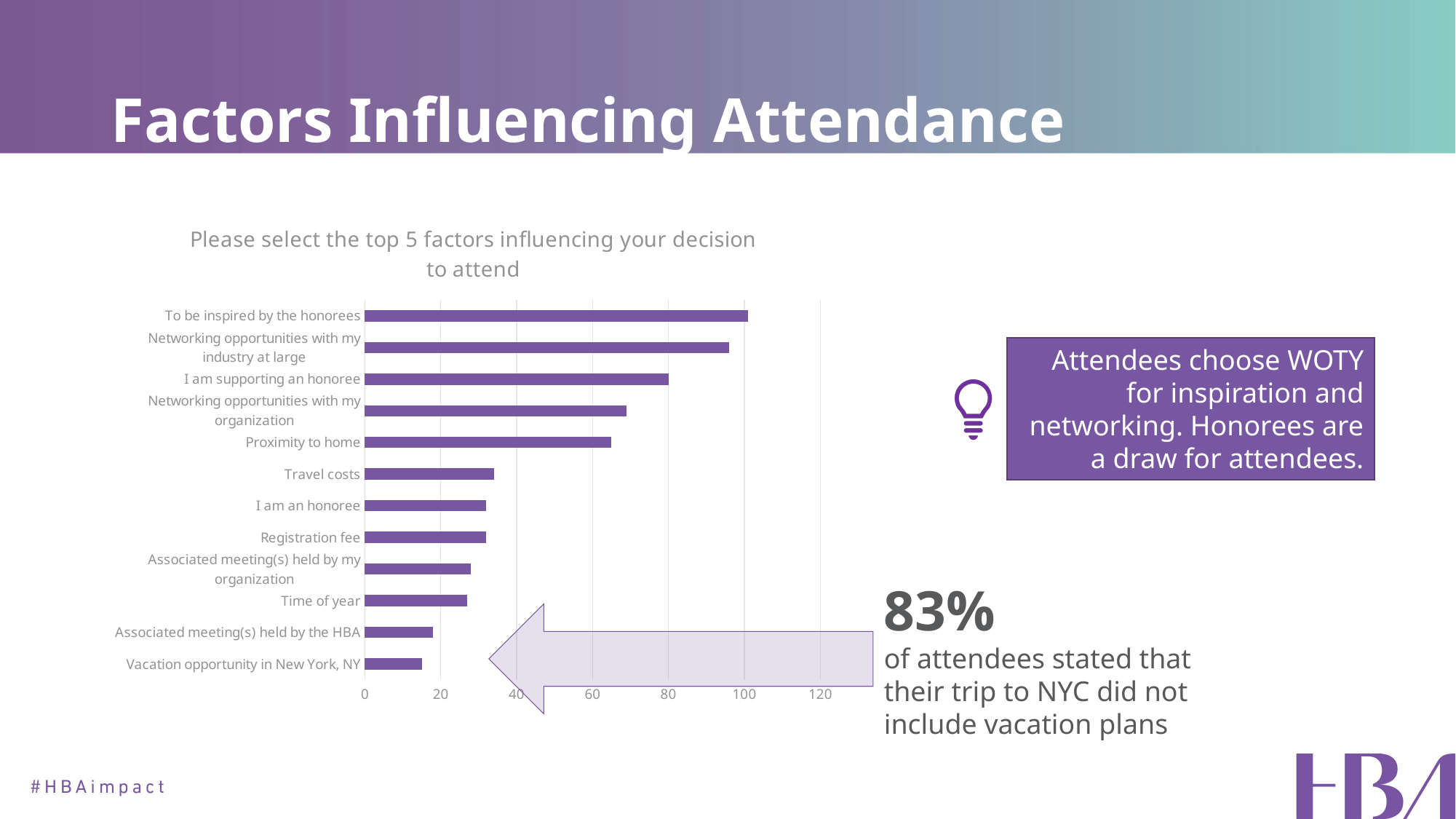
Is the value for 'Proximity to home' greater or less than 60? greater Which has the larger value: 'Proximity to home' or 'Time of year'? Proximity to home How many factors (categories) are plotted in the chart? 12 What is the title of the chart? Please select the top 5 factors influencing your decision to attend Is the value for 'Vacation opportunity in New York, NY' greater or less than 20? less Which has the larger value: 'Travel costs' or 'Vacation opportunity in New York, NY'? Travel costs Which factor has the highest value in the chart? To be inspired by the honorees What kind of chart is shown on the slide? bar chart Is the value for 'Travel costs' greater or less than 40? less Which factor has the lowest value in the chart? Vacation opportunity in New York, NY